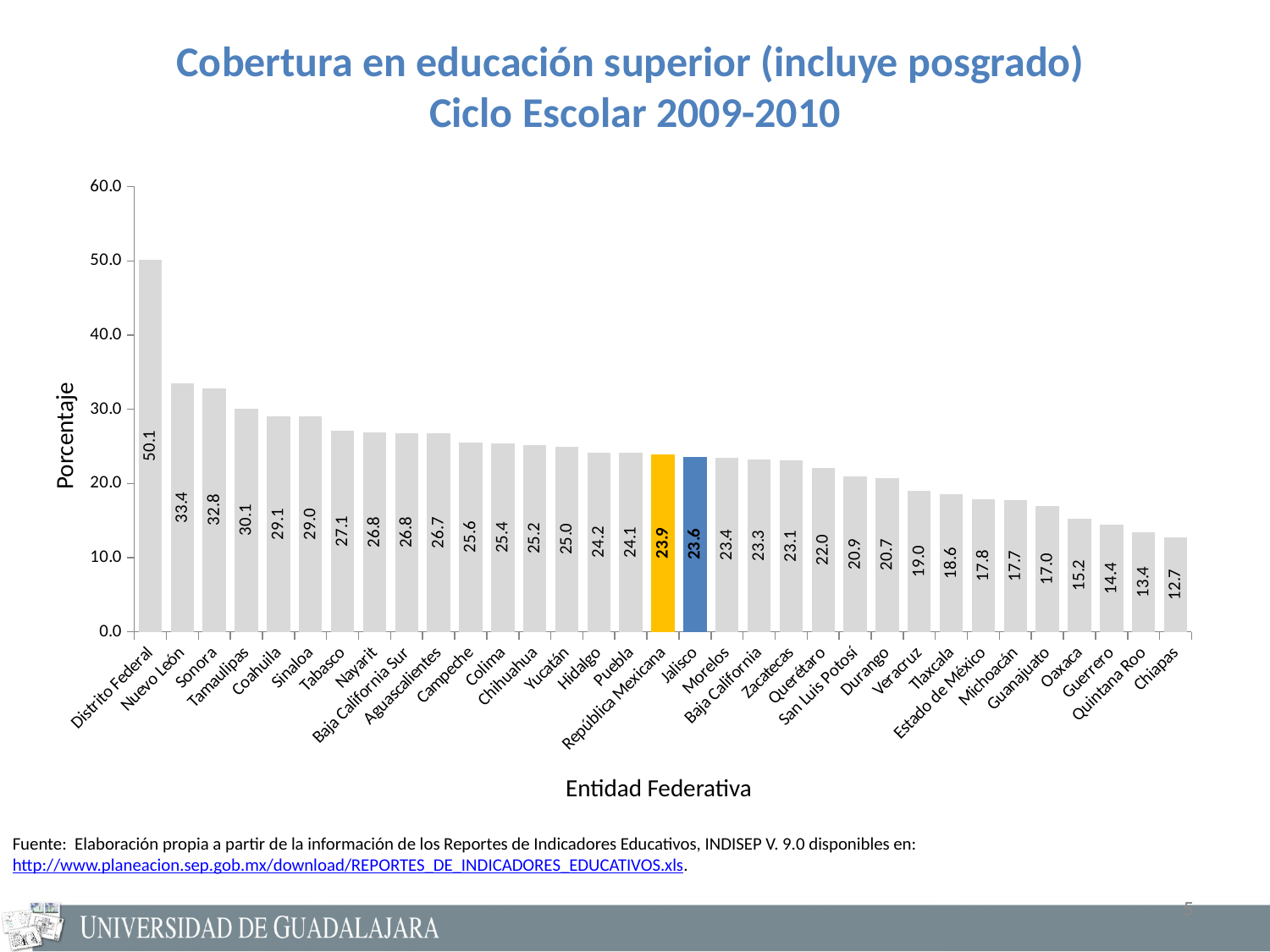
Which entity has the highest value? Distrito Federal What is the value for Distrito Federal? 50.1 Do the values rise or fall from left to right along the x axis? fall Which entity has the lowest value? Chiapas What is the difference between the values for Distrito Federal and Nuevo León? 16.7 What is the value for República Mexicana? 23.9 What is the difference between the values for República Mexicana and Jalisco? 0.3 What is the value for Jalisco? 23.6 Is the value for Veracruz greater or less than 20.0? less How many entities are shown on the x axis? 33 What kind of chart is this? bar chart Which has a larger value, Sonora or Tamaulipas? Sonora